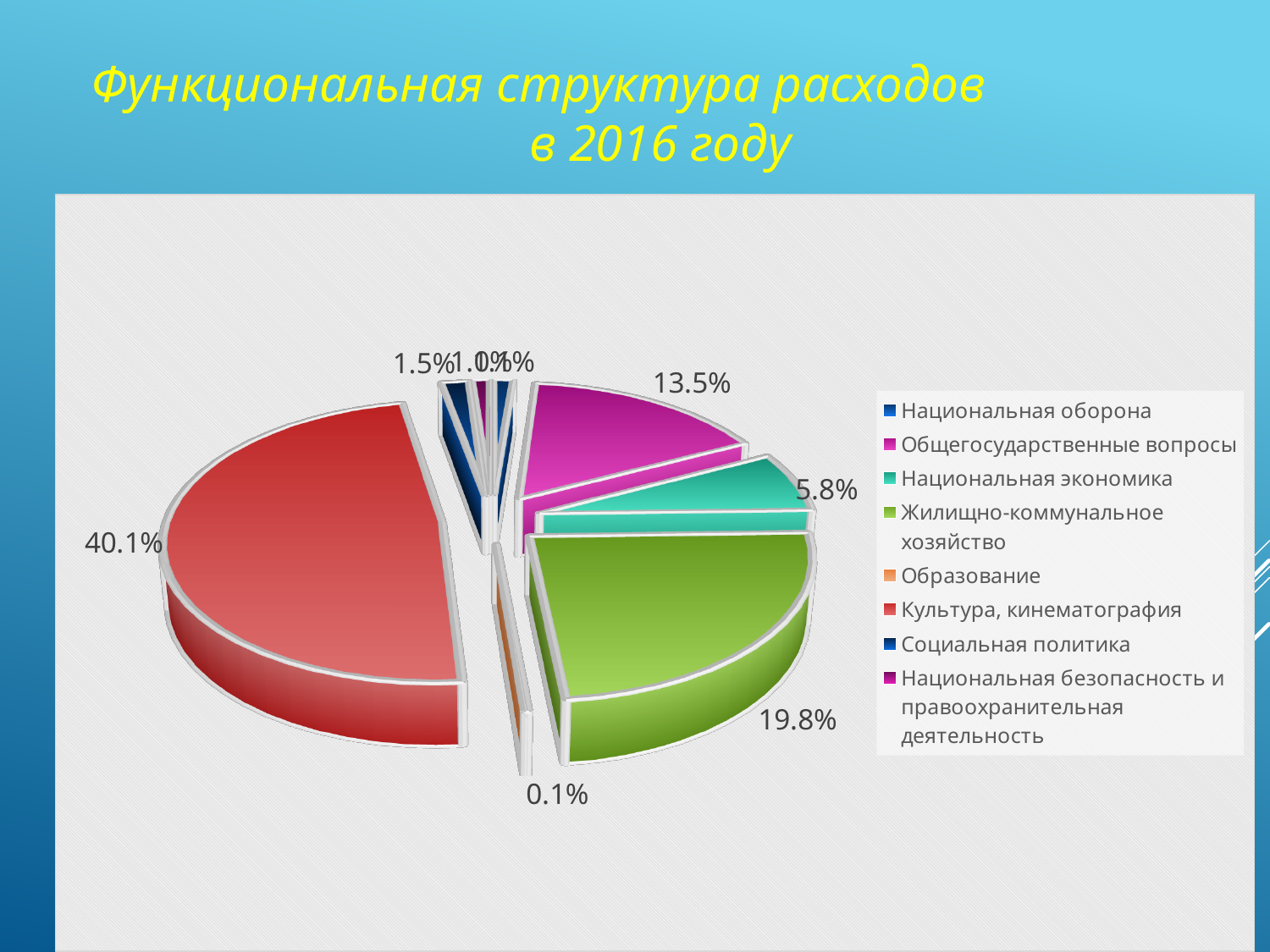
How many entries does the legend list? 8 What share of expenditures goes to Общегосударственные вопросы? 13.5% What colour is the slice for Культура, кинематография? Red What share of expenditures goes to Жилищно-коммунальное хозяйство? 19.8% Which category has the largest share of expenditures? Культура, кинематография What kind of chart is shown on the slide? Pie chart What is the title of the chart on the slide? Функциональная структура расходов в 2016 году What share of expenditures goes to Образование? 0.1% What is the difference in percentage points between Культура, кинематография and Жилищно-коммунальное хозяйство? 20.3 What share of expenditures goes to Культура, кинематография? 40.1% Which has a larger share: Общегосударственные вопросы or Национальная экономика? Общегосударственные вопросы What share of expenditures goes to Национальная экономика? 5.8%